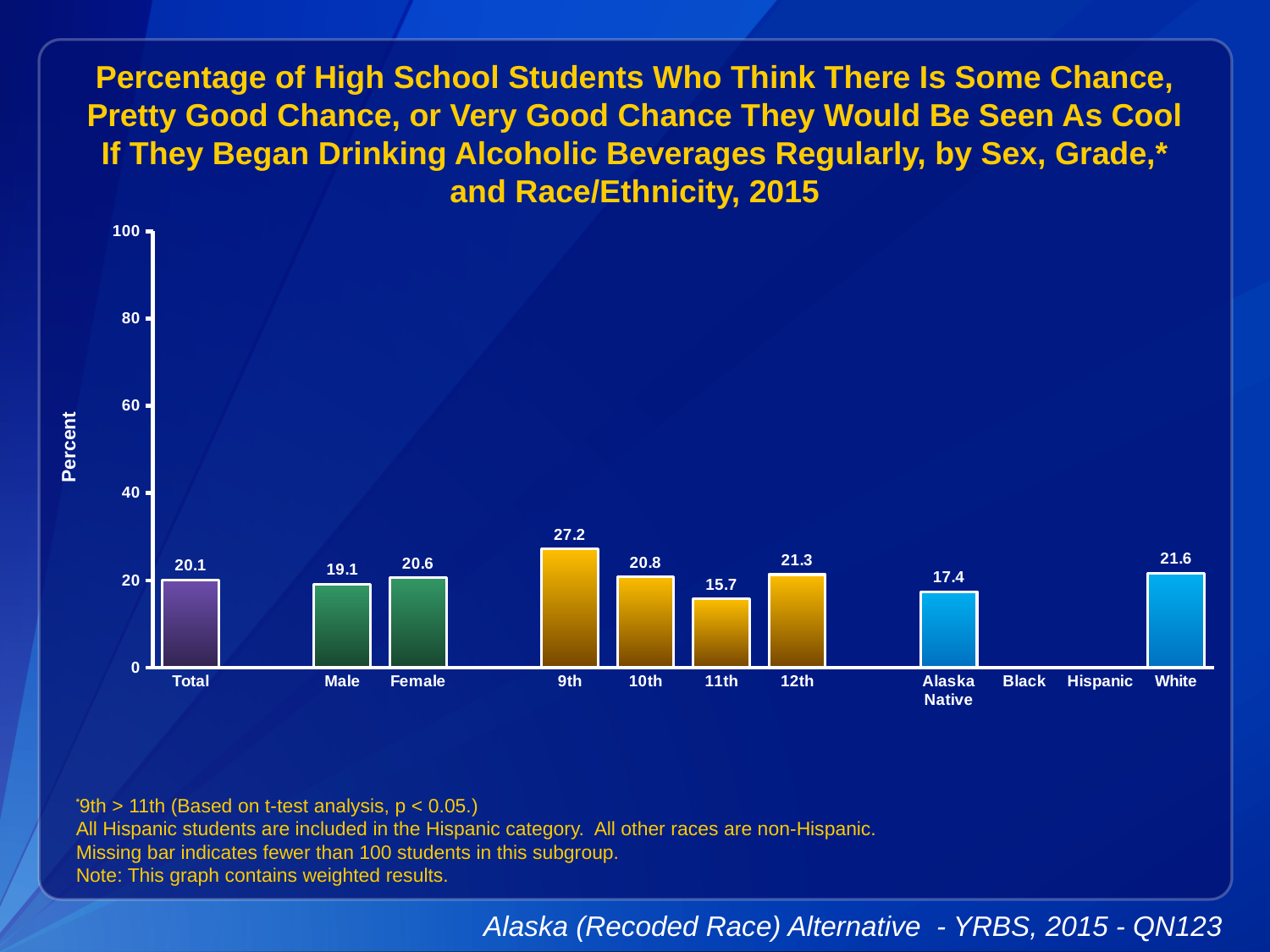
Which is larger, the value for Male or the value for Female? Female What is the label of the y axis? Percent What is the value for Female? 20.6 What is the difference between the values for 9th and 11th grade? 11.5 What is the value for 9th grade? 27.2 What is the value for Alaska Native? 17.4 What is the value for Total? 20.1 Which category with a bar has the lowest value? 11th How many categories have a bar plotted? 9 What kind of chart is shown? bar chart Which category has the highest value? 9th Is the value for 12th grade greater or less than 40? less